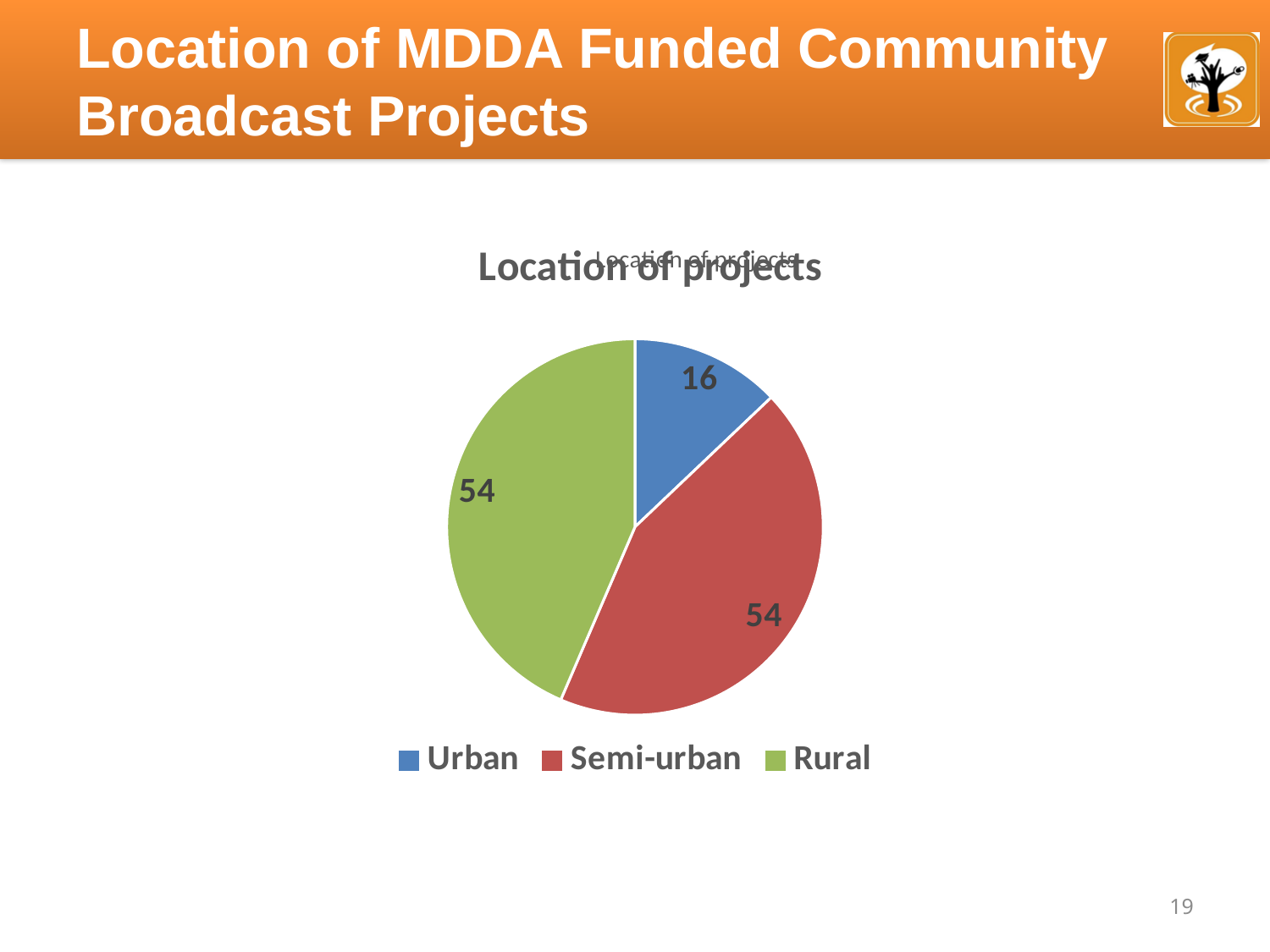
What type of chart is shown on the slide? Pie chart What is the title of the pie chart? Location of projects What is the value for Semi-urban in the pie chart? 54 What is the value for Rural in the pie chart? 54 What is the total of all the values shown in the pie chart? 124 What is the difference between the value for Rural and the value for Urban? 38 Which is larger, the value for Semi-urban or the value for Urban? Semi-urban Which category has the smallest slice in the pie chart? Urban Which colour represents Rural in the pie chart? Green How many categories does the pie chart show? 3 What is the value for Urban in the pie chart? 16 Which is larger, the value for Urban or the value for Rural? Rural